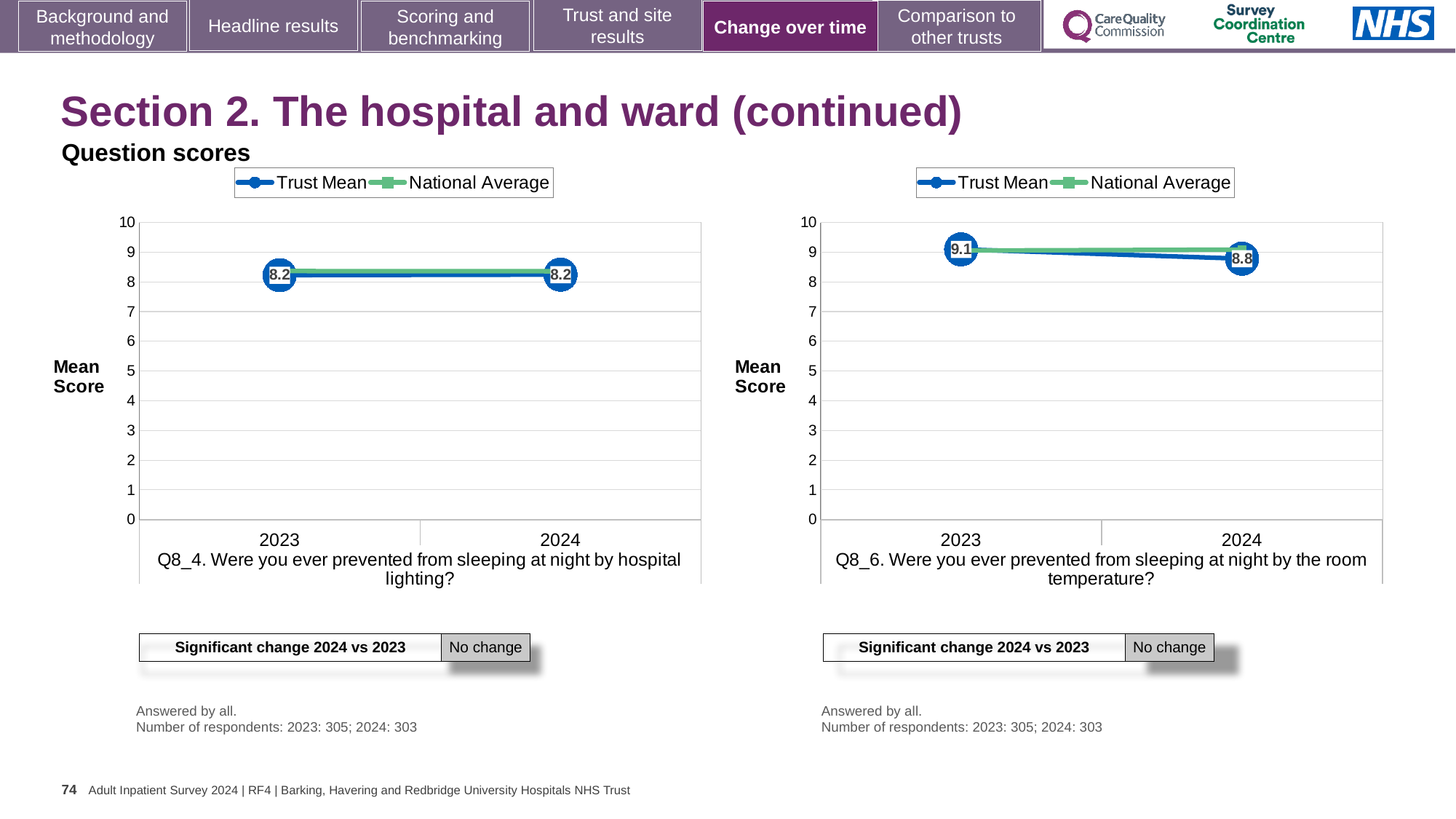
In the Q8_6 chart (right), is the National Average for 2023 greater or less than 8? greater In the Q8_6 chart (right), what is the Trust Mean for 2023? 9.1 In the Q8_4 chart (left), what is the Trust Mean for 2023? 8.2 In the Q8_6 chart (right), does the Trust Mean rise or fall from 2023 to 2024? fall In the Q8_4 chart (left), is the National Average for 2024 greater or less than 8? greater In the Q8_6 chart (right), which year has the higher Trust Mean, 2023 or 2024? 2023 In the Q8_4 chart (left), what is the Trust Mean for 2024? 8.2 How many years are shown on the x axis of the Q8_4 chart (left)? 2 In the Q8_6 chart (right), what is the Trust Mean for 2024? 8.8 In the Q8_6 chart (right), by how much did the Trust Mean change from 2023 to 2024? decreased by 0.3 What type of chart is the Q8_4 chart (left)? line chart How many series does the legend of the Q8_6 chart (right) list? 2